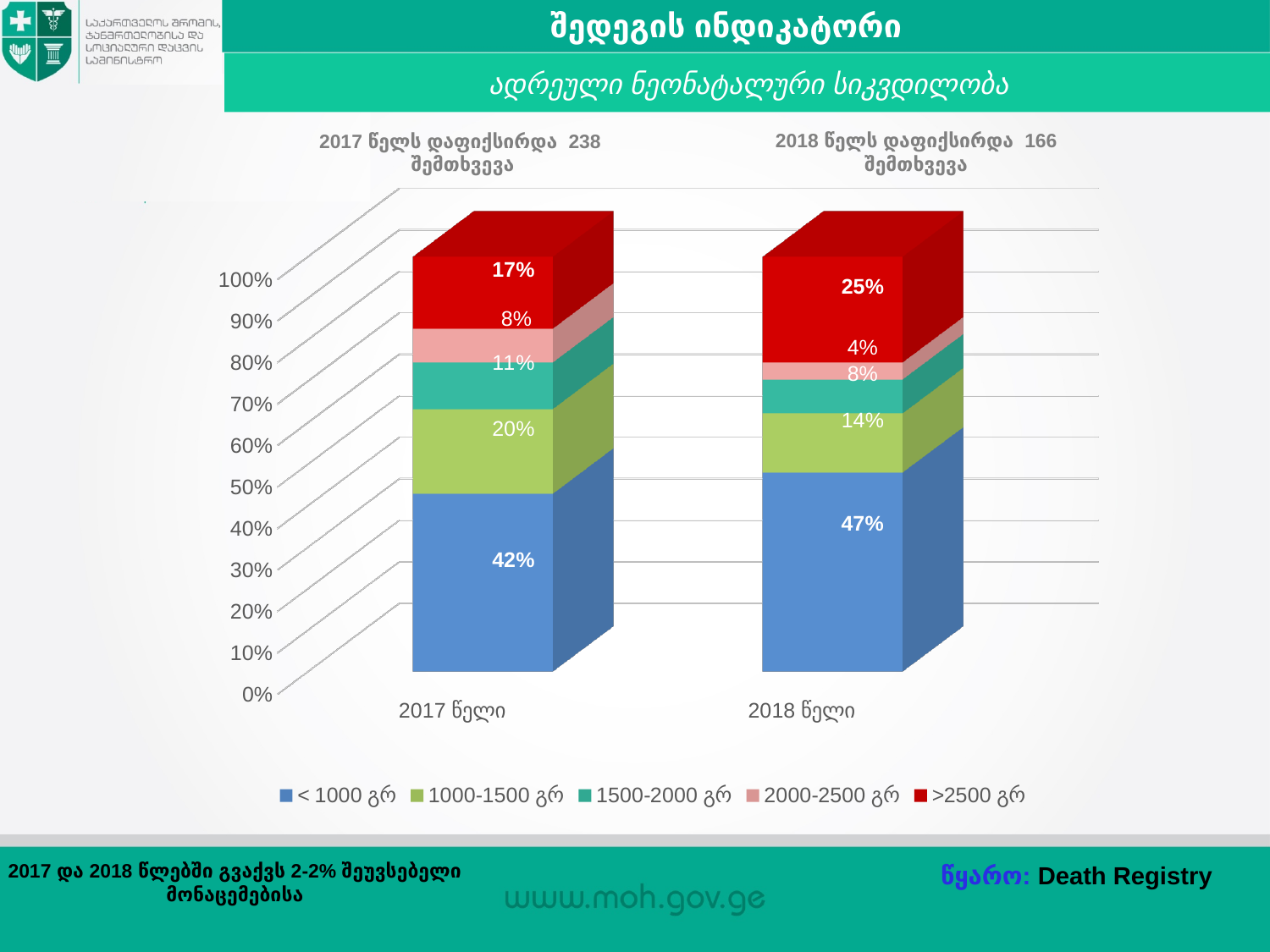
What is the difference between the >2500 გრ values for 2018 წელი and 2017 წელი? 8% What is the value of the < 1000 გრ segment for 2017 წელი? 42% According to the text above the chart, how many cases were recorded in 2017? 238 What is the value of the 2000-2500 გრ segment for 2017 წელი? 8% What is the value of the 1000-1500 გრ segment for 2018 წელი? 14% Which year has the larger 1500-2000 გრ share, 2017 წელი or 2018 წელი? 2017 წელი What is the value of the >2500 გრ segment for 2018 წელი? 25% Which segment is the largest in the 2018 წელი bar? < 1000 გრ Which segment is the smallest in the 2018 წელი bar? 2000-2500 გრ What type of chart is shown on the slide? stacked bar chart How many bars (categories) are plotted on the x axis? 2 How many series does the legend list? 5